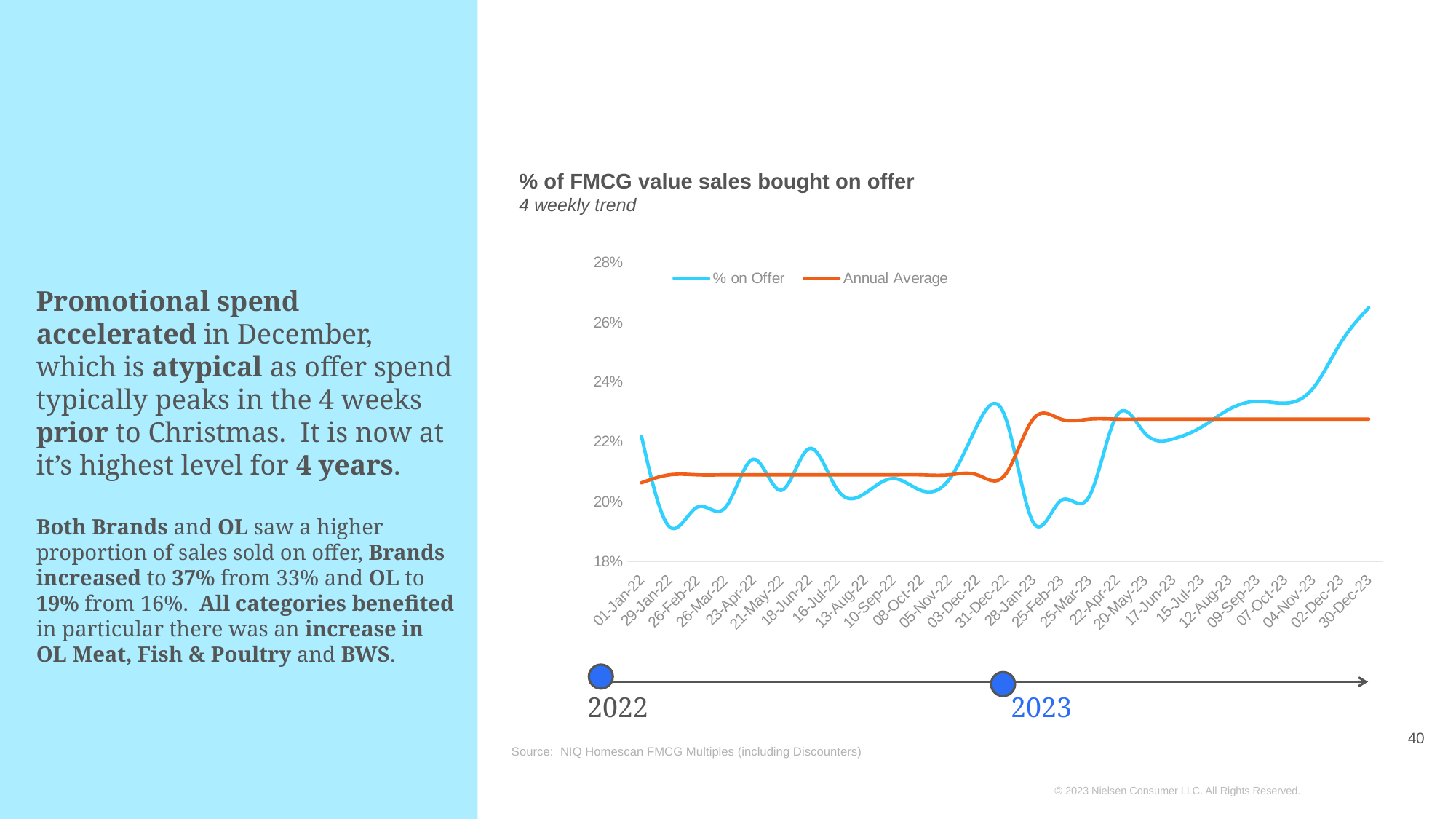
Does the % on Offer line rise or fall between 07-Oct-23 and 30-Dec-23? rise At which date does the % on Offer line reach its highest value? 30-Dec-23 Is the Annual Average line during 2022 greater or less than 22%? less Is the % on Offer value at 03-Dec-22 greater or less than 22%? greater Is the % on Offer value at 30-Dec-23 greater or less than 24%? greater What kind of chart is shown on the slide? line chart What is the title of the chart? % of FMCG value sales bought on offer How many dates are labelled along the x axis of the chart? 27 Which is larger: the % on Offer value at 30-Dec-23 or at 01-Jan-22? 30-Dec-23 How many series does the chart legend list? 2 What are the two series named in the chart legend? % on Offer and Annual Average